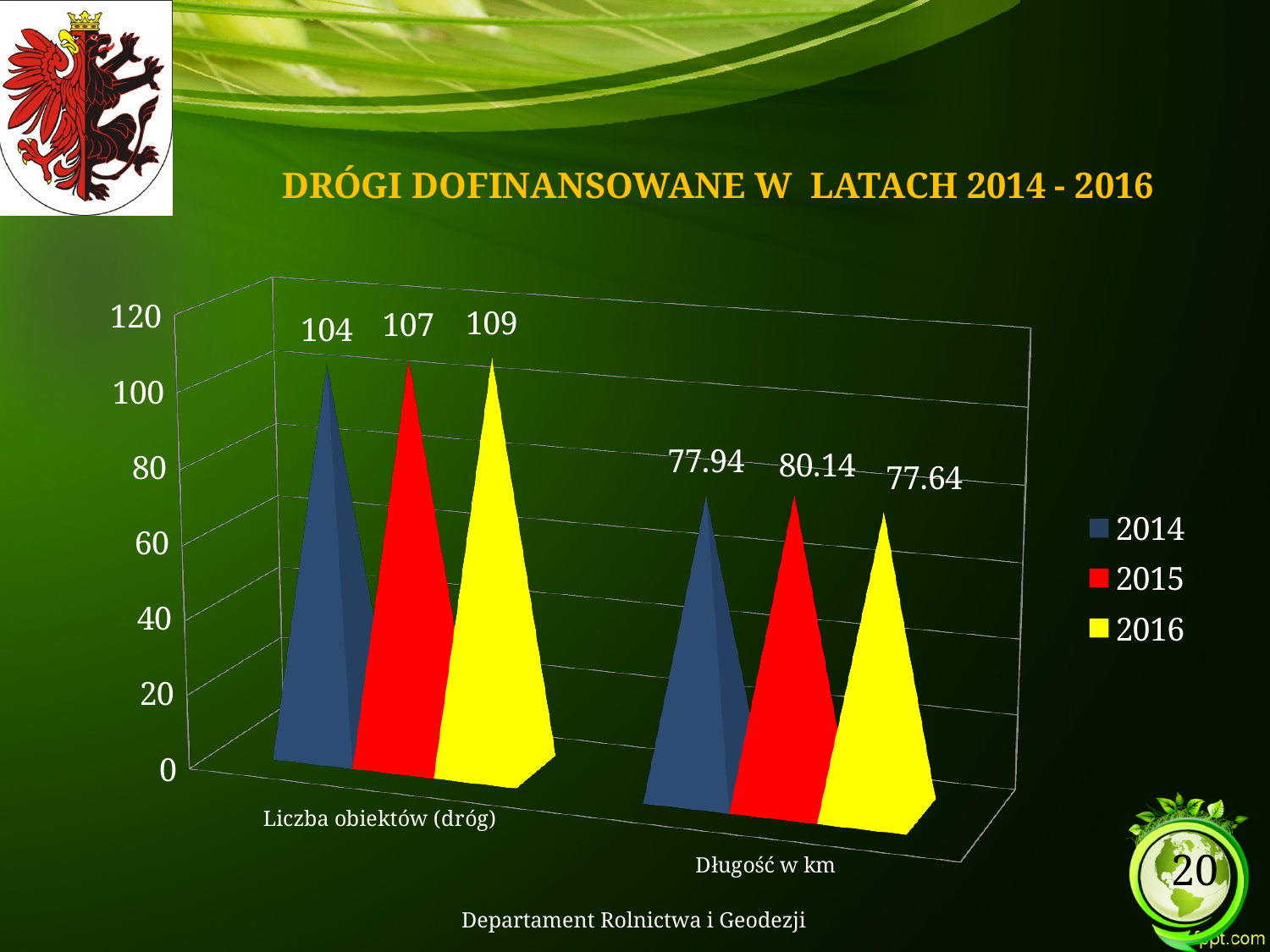
What is the value for 2015 in the "Długość w km" category? 80.14 What is the value for 2016 in the "Liczba obiektów (dróg)" category? 109 What type of chart is shown on the slide? bar chart What is the value for 2014 in the "Długość w km" category? 77.94 How many series does the legend list? 3 Which year has the highest value in the "Liczba obiektów (dróg)" category? 2016 How many categories are shown on the x axis of the chart? 2 What is the difference between the 2015 and 2016 values in the "Długość w km" category? 2.5 Which year has the lowest value in the "Długość w km" category? 2016 What is the difference between the 2016 and 2014 values in the "Liczba obiektów (dróg)" category? 5 What colour represents the 2015 series in the chart? red Which is larger in the "Długość w km" category: the value for 2015 or the value for 2014? 2015